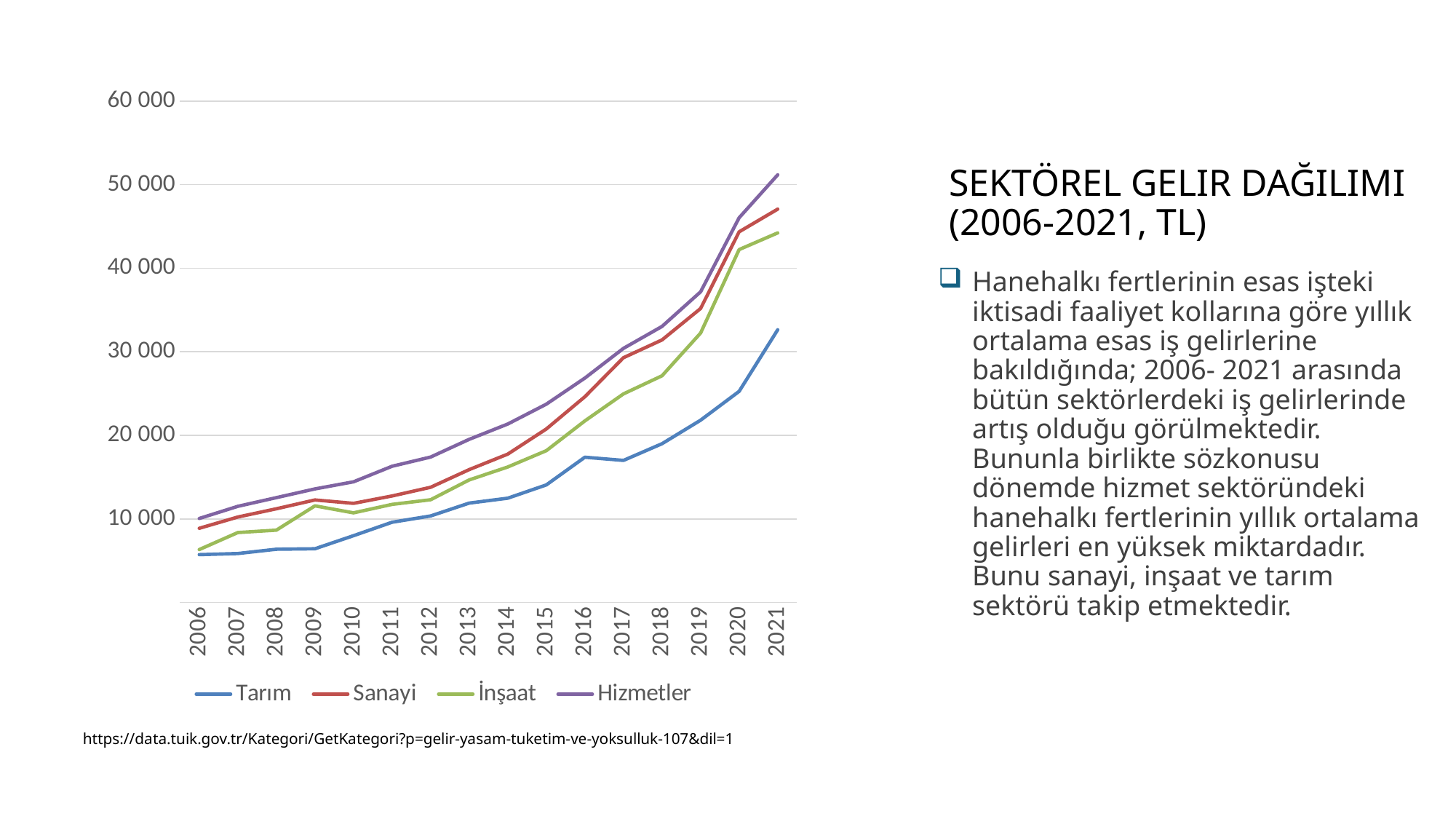
In 2018, which is larger: the value for Sanayi or the value for İnşaat? Sanayi What kind of chart is shown on the slide? Line chart What colour is the Hizmetler line in the legend? Purple How many years are shown on the x axis? 16 How many series does the legend list? 4 Is the value for Tarım in 2006 greater or less than 10 000? less Is the value for Sanayi in 2021 greater or less than 40 000? greater Do the values for Tarım generally rise or fall from 2006 to 2021? Rise Is the value for Tarım in 2021 greater or less than 30 000? greater Which sector has the highest value in 2021? Hizmetler Which sector has the lowest value in 2021? Tarım